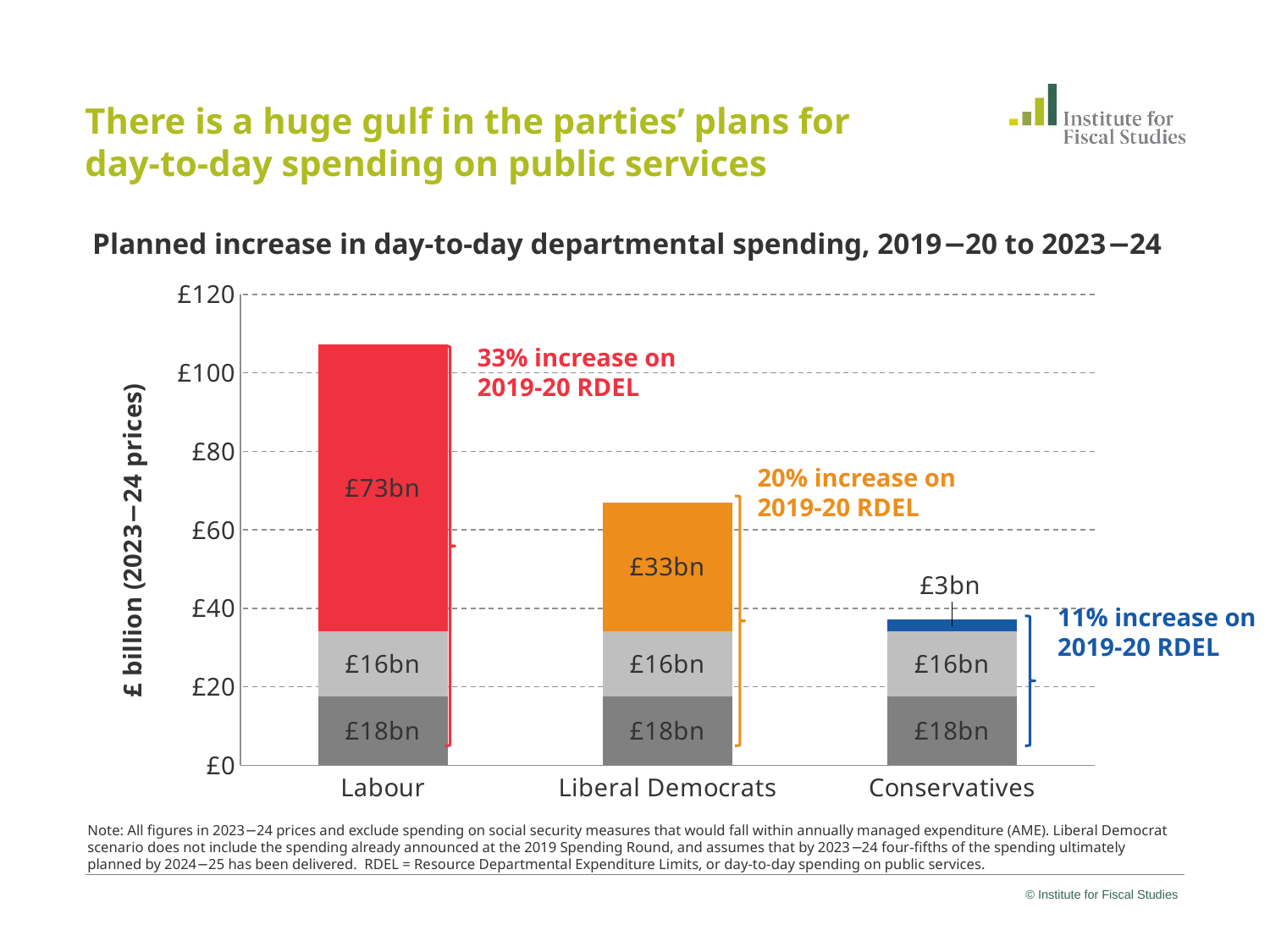
What is the difference between the Labour party-specific segment (£73bn) and the Liberal Democrats party-specific segment (£33bn)? £40bn What is the value of the blue segment of the Conservatives bar? £3bn Which party has the tallest stacked bar? Labour What is the value of the bottom (dark grey) segment of the Conservatives bar? £18bn Is the total of the Liberal Democrats bar greater or less than £60? greater What is the total of the Conservatives stacked bar? £37bn What is the value of the top (red) segment of the Labour bar? £73bn What is the total of the Labour stacked bar? £107bn What percentage increase on 2019-20 RDEL is annotated for the Conservatives? 11% What is the value of the orange segment of the Liberal Democrats bar? £33bn How many parties (categories) are shown on the x axis? 3 Which party has the shortest stacked bar? Conservatives